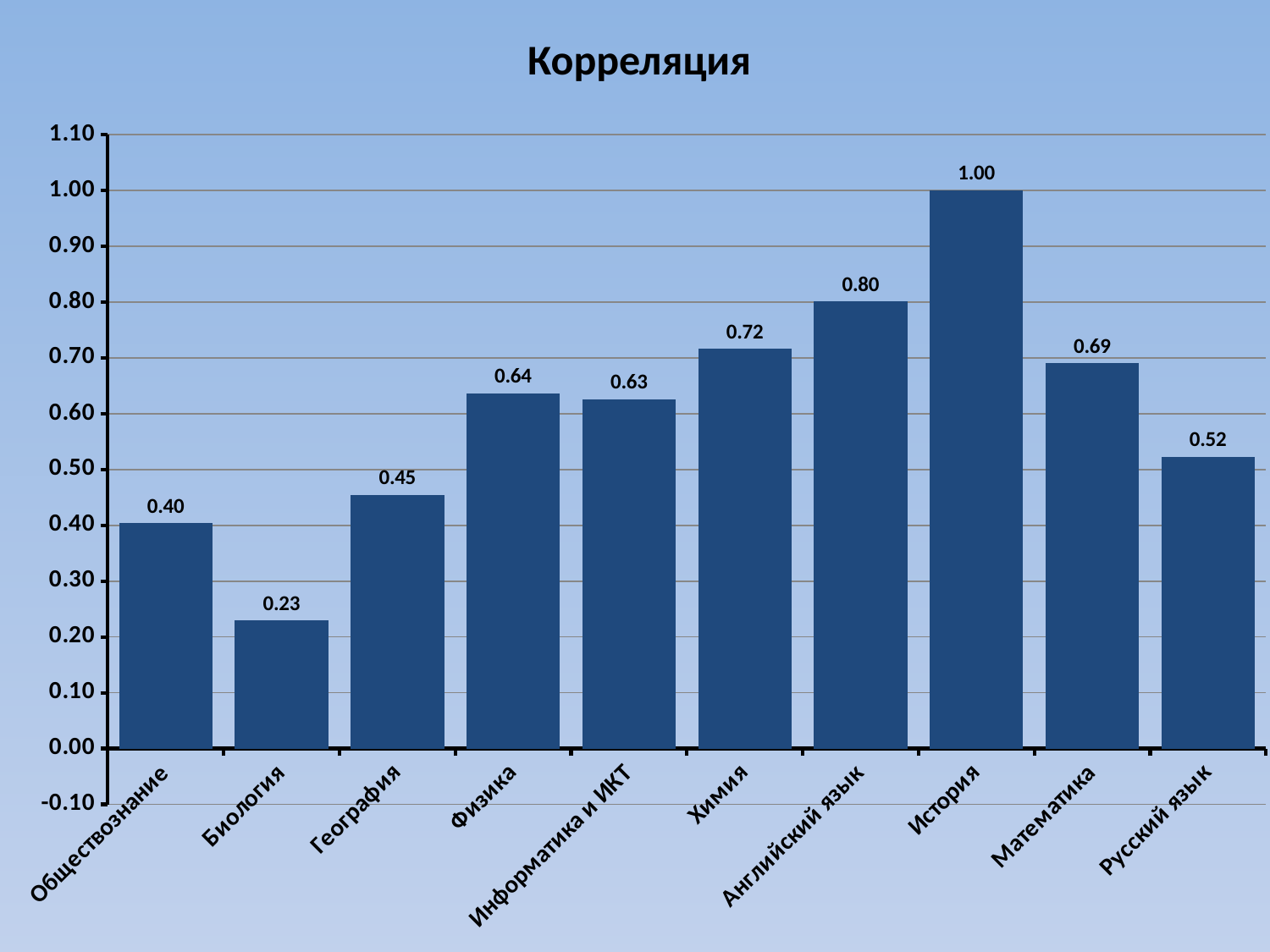
What is the title of the chart? Корреляция What is the value for История? 1.00 What kind of chart is shown on the slide? bar chart Is the value for География greater or less than 0.50? less What is the value for Информатика и ИКТ? 0.63 Which category has the lowest value? Биология Which is larger, the value for Математика or the value for Русский язык? Математика How many categories are shown on the chart? 10 Which category has the highest value? История What is the difference between the values for Английский язык and Химия? 0.08 What is the value for Биология? 0.23 What is the difference between the values for Физика and Обществознание? 0.24